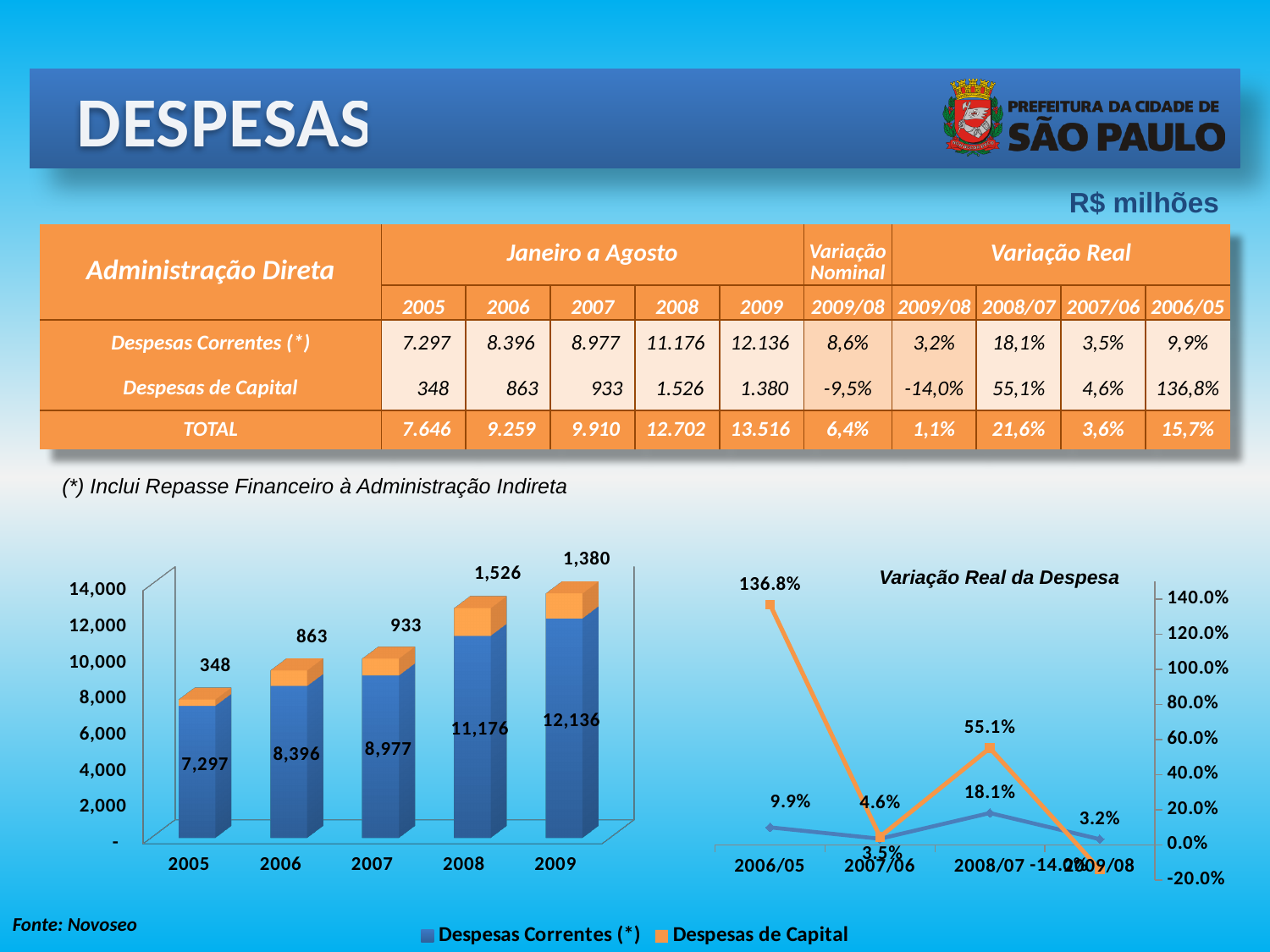
In the stacked bar chart on the left, what is the value of Despesas Correntes (*) for 2009? 12,136 In the stacked bar chart on the left, what is the difference between Despesas Correntes (*) in 2008 and in 2007? 2,199 What kind of chart is the chart on the left of the slide? Stacked bar chart In the stacked bar chart on the left, which year has the highest value for Despesas Correntes (*)? 2009 In the stacked bar chart on the left, which year has the lowest value for Despesas de Capital? 2005 In the stacked bar chart on the left, how many years are shown on the x axis? 5 How many series does the legend at the bottom of the slide list? 2 In the chart titled 'Variação Real da Despesa', which period has the lowest value for Despesas de Capital? 2009/08 In the chart titled 'Variação Real da Despesa', what is the value of the Despesas de Capital line for 2006/05? 136.8% In the stacked bar chart on the left, what is the value of Despesas de Capital for 2008? 1,526 In the chart titled 'Variação Real da Despesa', what is the value of the Despesas Correntes (*) line for 2008/07? 18.1% In the stacked bar chart on the left, what is the total of the stacked bar for 2009? 13,516